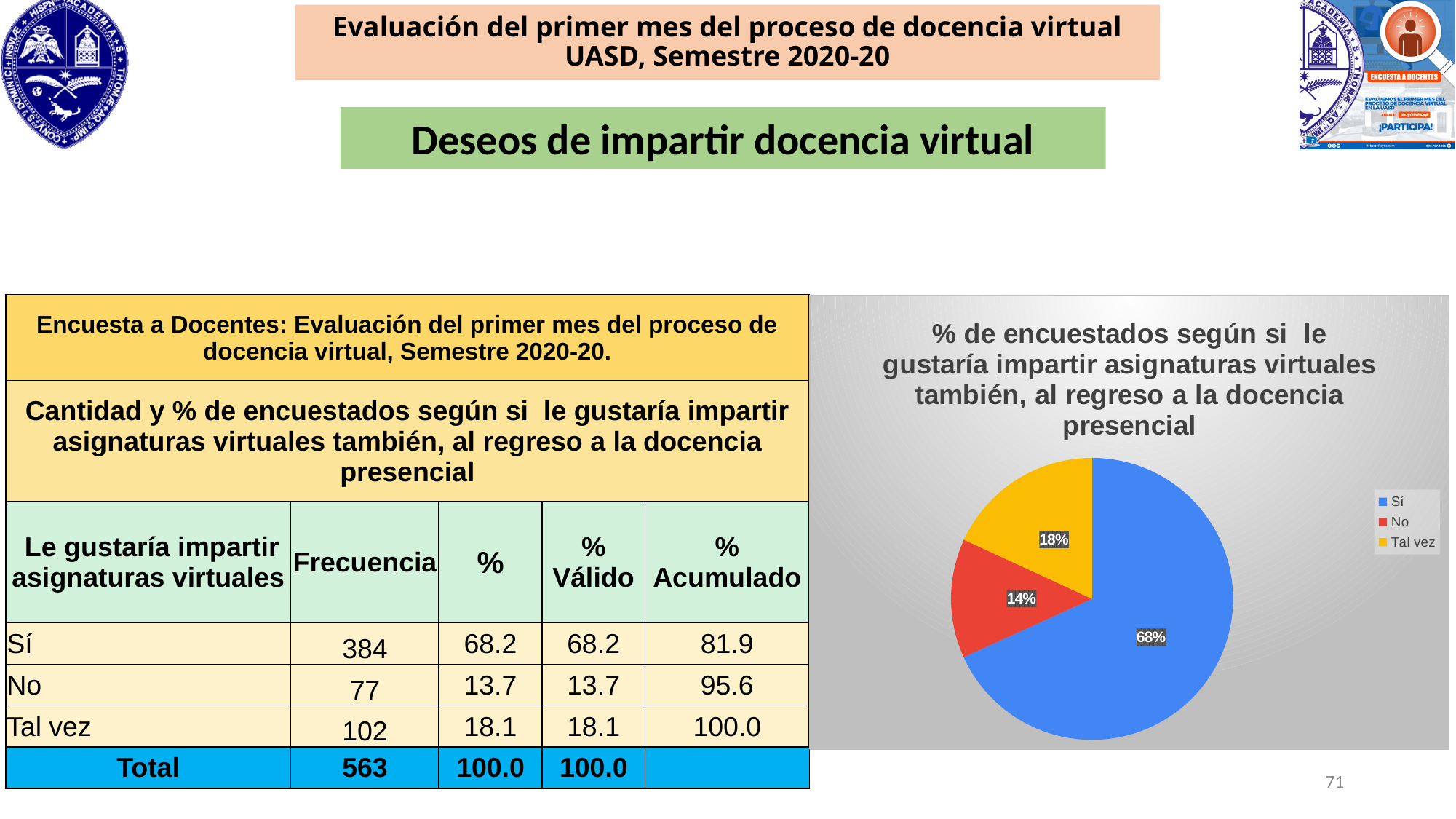
What percentage of the pie chart corresponds to "Sí"? 68% Which category has the smallest slice in the pie chart? No Which category has the largest slice in the pie chart? Sí What percentage of the pie chart corresponds to "Tal vez"? 18% How many categories does the pie chart show? 3 How many entries does the legend of the pie chart list? 3 What is the difference in percentage points between the "Tal vez" slice and the "No" slice? 4% Which slice is larger in the pie chart, "No" or "Tal vez"? Tal vez What percentage of the pie chart corresponds to "No"? 14% What is the difference in percentage points between the "Sí" slice and the "Tal vez" slice? 50% What colour is the "Sí" slice in the pie chart? blue What kind of chart is shown on the slide? pie chart